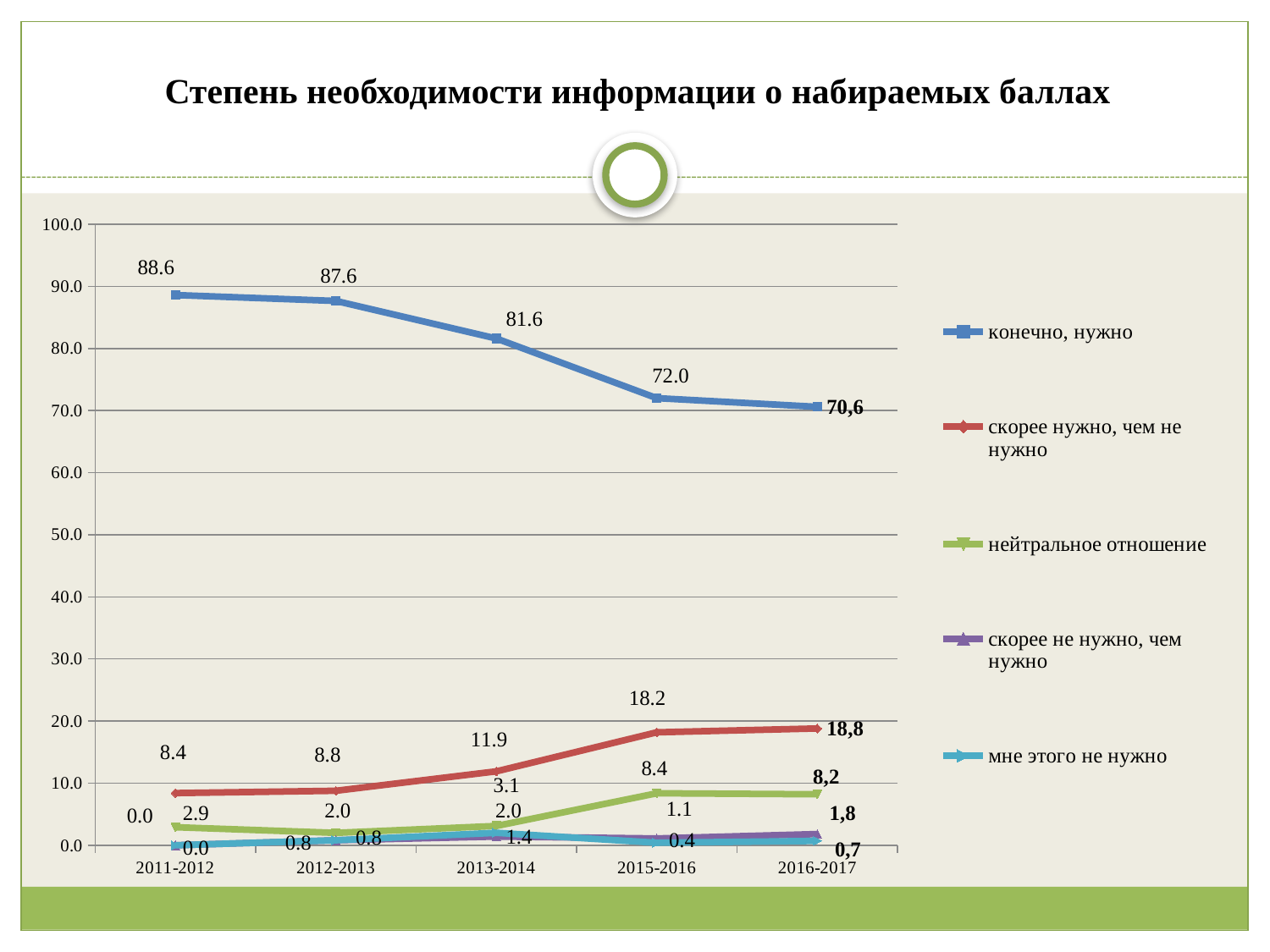
What is the value for «мне этого не нужно» in 2016-2017? 0,7 Does the value for «конечно, нужно» rise or fall from 2011-2012 to 2016-2017? fall What is the value for «нейтральное отношение» in 2016-2017? 8,2 How many series does the legend list? 5 In which period is the value for «конечно, нужно» the lowest? 2016-2017 What is the value for «скорее нужно, чем не нужно» in 2015-2016? 18.2 In which period is the value for «конечно, нужно» the highest? 2011-2012 What kind of chart is shown on the slide? line chart What is the difference between the «конечно, нужно» values in 2011-2012 and 2015-2016? 16.6 How many periods are shown on the x axis? 5 In 2013-2014, which is larger: «скорее нужно, чем не нужно» or «нейтральное отношение»? скорее нужно, чем не нужно What is the value for «конечно, нужно» in 2011-2012? 88.6